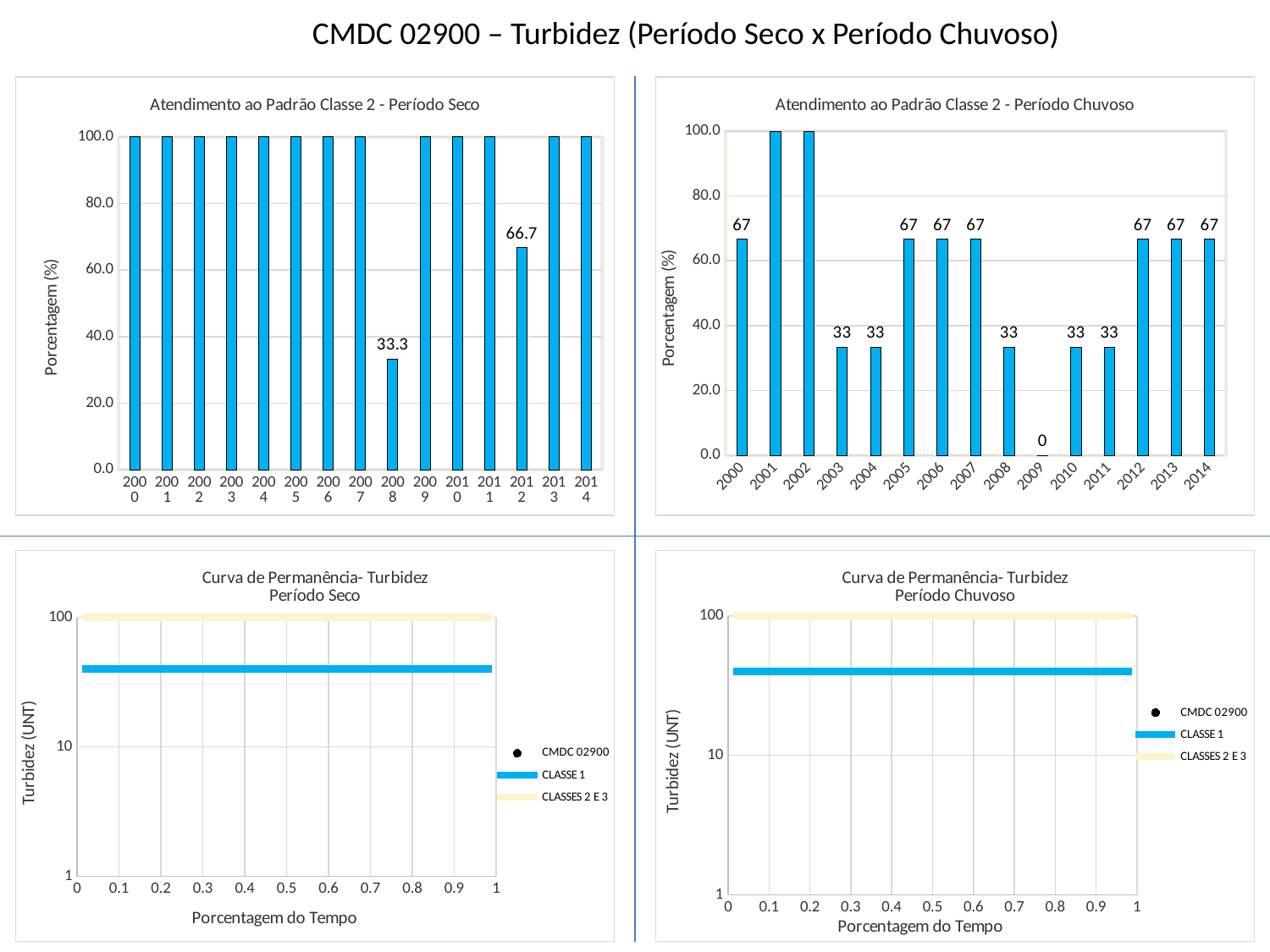
How many series does the legend list in the chart titled "Curva de Permanência- Turbidez Período Chuvoso"? 3 In the chart titled "Atendimento ao Padrão Classe 2 - Período Seco", which year has the lowest value? 2008 How many years are shown on the x axis of the chart titled "Atendimento ao Padrão Classe 2 - Período Seco"? 15 In the chart titled "Atendimento ao Padrão Classe 2 - Período Seco", what is the difference between the values for 2012 and 2008? 33.4 In the chart titled "Atendimento ao Padrão Classe 2 - Período Chuvoso", which year has the lowest value? 2009 In the chart titled "Atendimento ao Padrão Classe 2 - Período Chuvoso", is the value for 2003 greater or less than 40.0? less In the chart titled "Atendimento ao Padrão Classe 2 - Período Seco", what is the value for 2008? 33.3 In the chart titled "Atendimento ao Padrão Classe 2 - Período Seco", what is the value for 2012? 66.7 In the chart titled "Atendimento ao Padrão Classe 2 - Período Chuvoso", which is larger, the value for 2007 or the value for 2008? 2007 In the chart titled "Atendimento ao Padrão Classe 2 - Período Chuvoso", what is the difference between the values for 2000 and 2004? 34 In the chart titled "Atendimento ao Padrão Classe 2 - Período Chuvoso", what is the value for 2005? 67 In the chart titled "Atendimento ao Padrão Classe 2 - Período Chuvoso", what is the value for 2009? 0